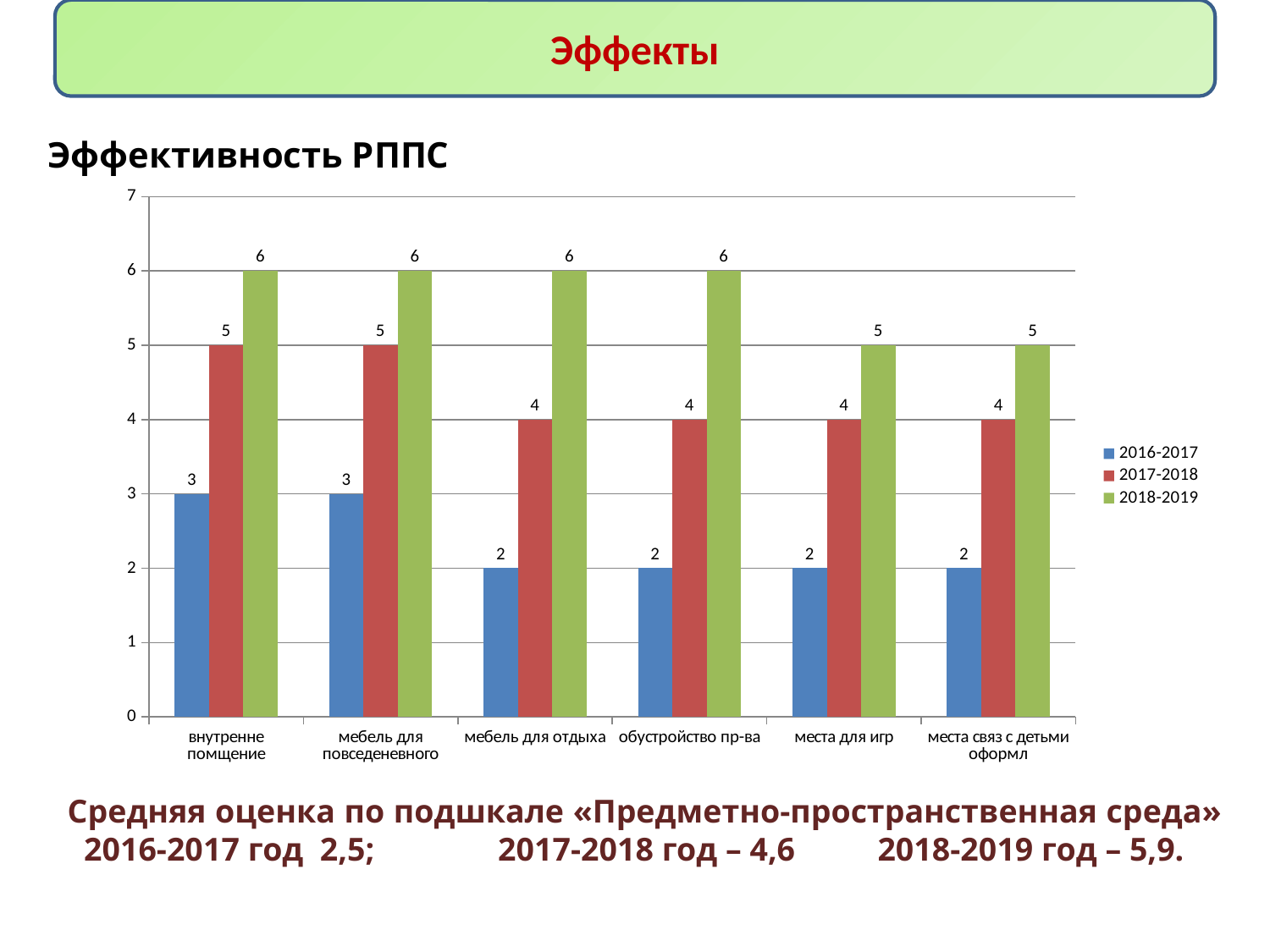
What is the value for 2018-2019 in the category "места для игр"? 5 What is the value for 2016-2017 in the category "внутренне помщение"? 3 What kind of chart is shown on the slide? bar chart How many categories are shown on the x axis? 6 Which series has the highest value in the category "обустройство пр-ва"? 2018-2019 Which series has the lowest value in the category "мебель для повседеневного"? 2016-2017 What is the difference between the 2018-2019 and 2016-2017 values in the category "мебель для отдыха"? 4 How many series does the legend list? 3 What is the value for 2017-2018 in the category "мебель для отдыха"? 4 Which is larger in the category "места для игр": the 2017-2018 value or the 2016-2017 value? 2017-2018 Does the 2016-2017 series rise or fall from "внутренне помщение" to "места связ с детьми оформл"? fall What is the title of the chart? Эффективность РППС